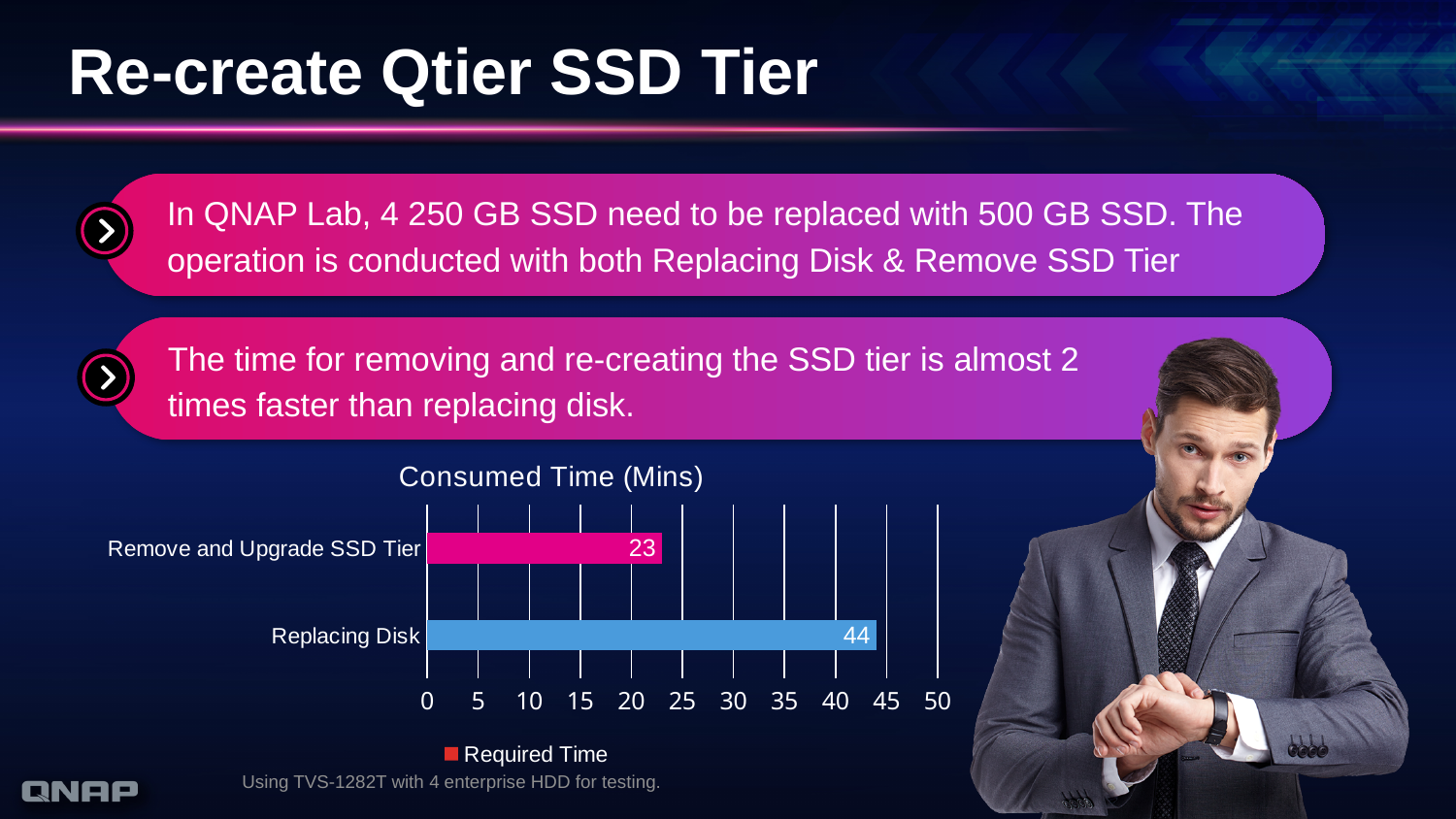
What is the title of the chart? Consumed Time (Mins) How many series does the legend list? 1 Which category has the lowest consumed time? Remove and Upgrade SSD Tier What kind of chart is shown on the slide? Bar chart Which category has the highest consumed time? Replacing Disk How many categories are shown in the chart? 2 Is the value for Replacing Disk greater or less than 40? greater Which takes longer, Replacing Disk or Remove and Upgrade SSD Tier? Replacing Disk Is the value for Remove and Upgrade SSD Tier greater or less than 25? less What is the difference in consumed time between Replacing Disk and Remove and Upgrade SSD Tier? 21 What is the consumed time for Replacing Disk? 44 What is the consumed time for Remove and Upgrade SSD Tier? 23